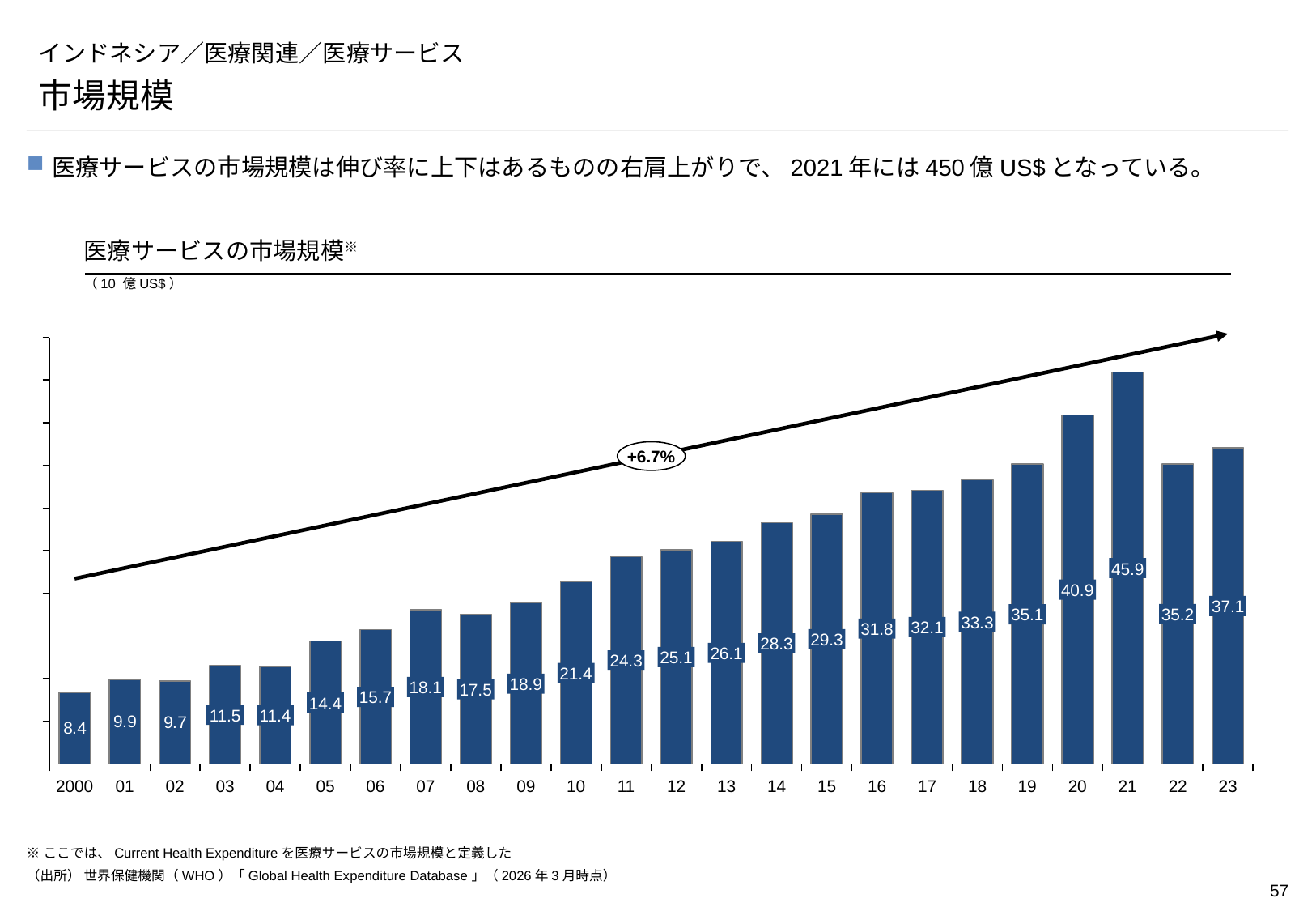
Which year has the lowest value? 2000 How many years (bars) are shown in the chart? 24 What is the value for 2000? 8.4 What is the value for 2010? 21.4 What is the difference between the values for 2023 and 2022? 1.9 Which year has the highest value? 21 What kind of chart is shown on the slide? Bar chart What growth rate is written on the arrow above the bars? +6.7% Which is larger, the value for 2007 or the value for 2008? 2007 Do the values generally rise or fall from 2000 to 2021? Rise What is the value for 2021? 45.9 What is the difference between the values for 2021 and 2020? 5.0